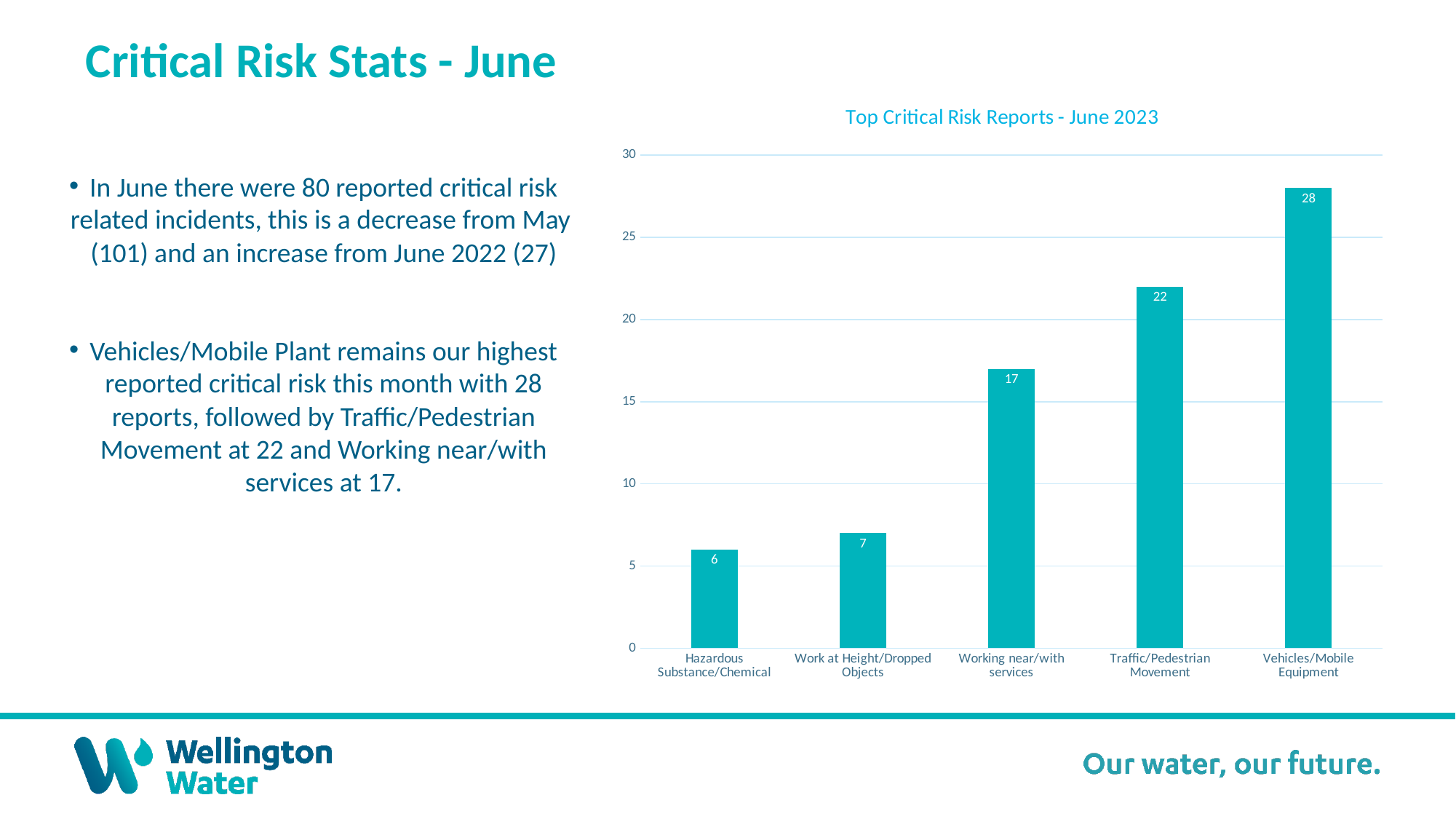
What is the value for Working near/with services? 17 Which category has the highest value? Vehicles/Mobile Equipment What is the value for Hazardous Substance/Chemical? 6 What kind of chart is shown on the slide? bar chart What is the value for Vehicles/Mobile Equipment? 28 Which category has the lowest value? Hazardous Substance/Chemical What is the difference between Working near/with services and Work at Height/Dropped Objects? 10 What is the title of the chart? Top Critical Risk Reports - June 2023 Which is larger, Traffic/Pedestrian Movement or Working near/with services? Traffic/Pedestrian Movement Is the value for Traffic/Pedestrian Movement greater or less than 20? greater How many categories are shown on the chart? 5 What is the difference between Vehicles/Mobile Equipment and Traffic/Pedestrian Movement? 6